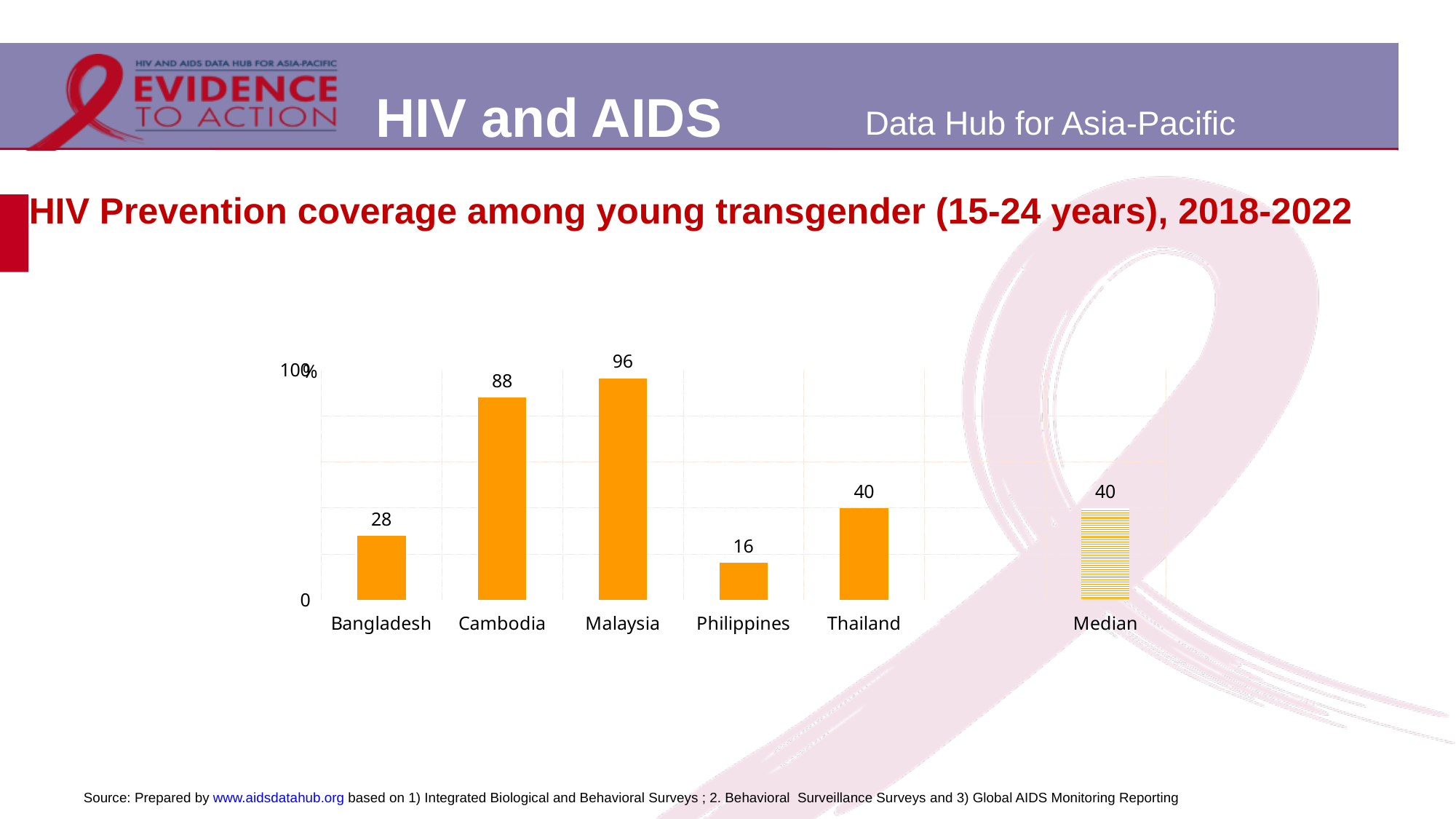
Which has a higher value, Thailand or Bangladesh? Thailand Which country has the lowest HIV prevention coverage on the chart? Philippines What is the difference between the values for Malaysia and Bangladesh? 68 What is the HIV prevention coverage value shown for Cambodia? 88 What kind of chart is shown on the slide? Bar chart What is the value shown for the Philippines? 16 What is the value shown for the Median bar? 40 What is the maximum value shown on the vertical axis? 100% Is the value for Thailand equal to the Median value? Yes How many countries (excluding the Median) are plotted on the chart? 5 What is the title of the chart on the slide? HIV Prevention coverage among young transgender (15-24 years), 2018-2022 Which country has the highest HIV prevention coverage on the chart? Malaysia